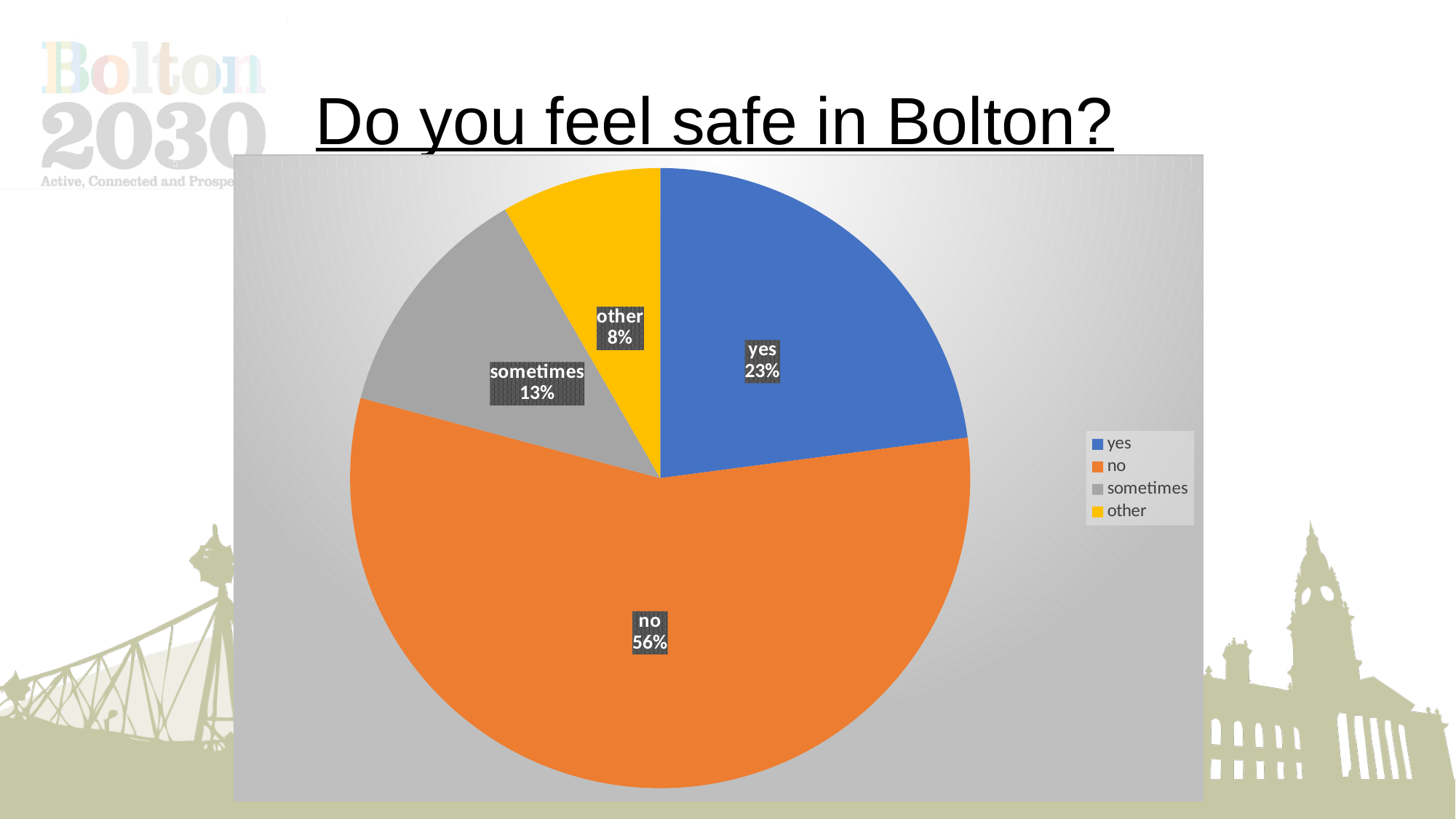
How many slices does the pie chart have? 4 Which is larger, the share for "sometimes" or the share for "other"? sometimes How many entries does the legend list? 4 What kind of chart is shown on the slide? pie chart Which response has the smallest share of the pie? other What is the title of the slide above the chart? Do you feel safe in Bolton? What percentage of respondents answered "sometimes"? 13% What is the difference in percentage points between "no" and "yes"? 33 What percentage of respondents answered "other"? 8% Which response has the largest share of the pie? no What percentage of respondents answered "no"? 56% What percentage of respondents answered "yes"? 23%